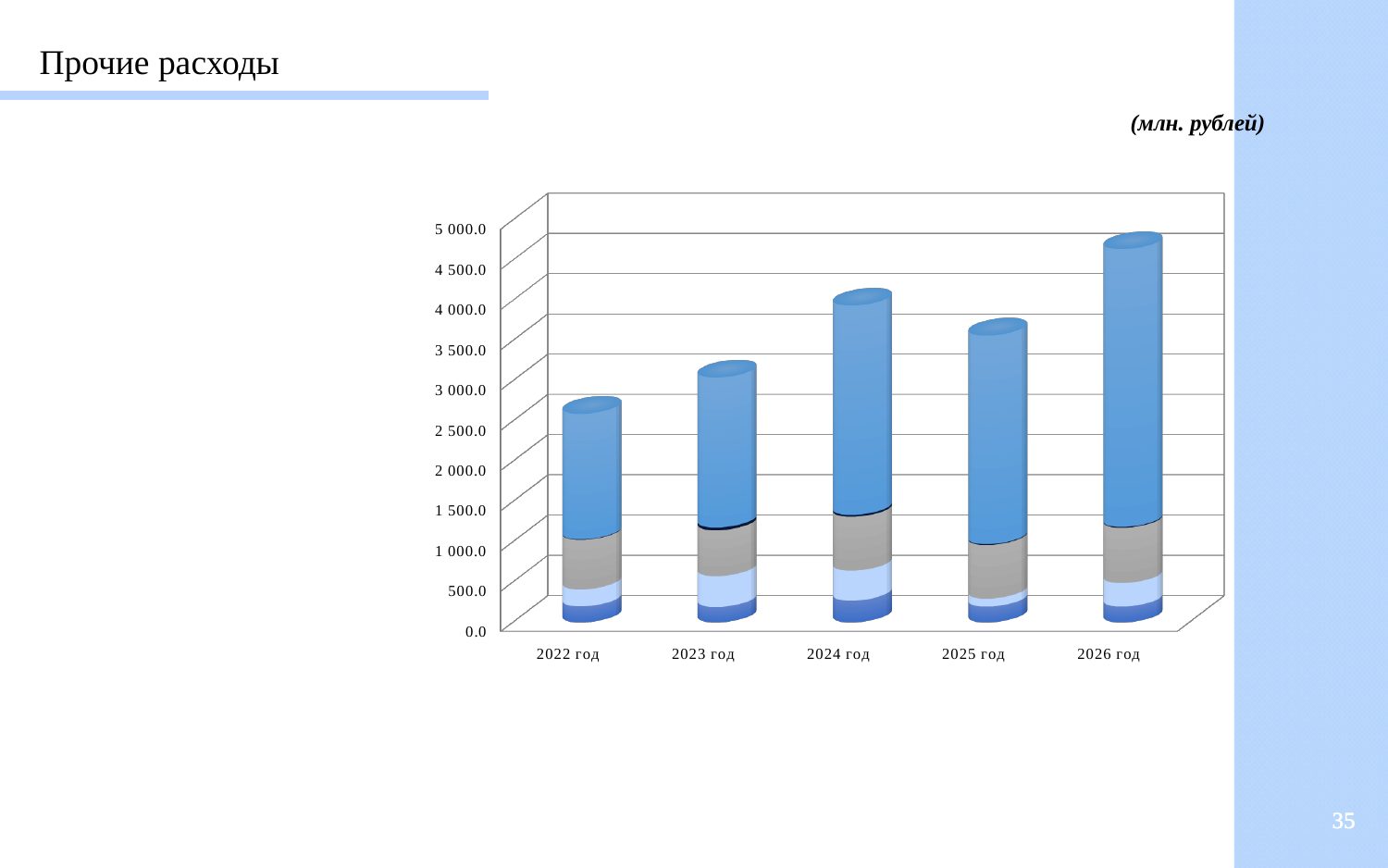
Which bar is taller, 2024 год or 2025 год? 2024 год Is the total bar for 2026 год greater or less than 4 000.0? greater In what units are the chart values given, according to the slide? млн. рублей What kind of chart is shown on the slide? Stacked bar chart Is the total bar for 2025 год greater or less than 4 000.0? less Is the total bar for 2022 год greater or less than 3 000.0? less What is the title of the slide containing the chart? Прочие расходы How many years (categories) are shown on the x axis of the chart? 5 Which year has the shortest stacked bar? 2022 год Which year has the tallest stacked bar? 2026 год Do the bar totals rise or fall from 2022 год to 2024 год? rise